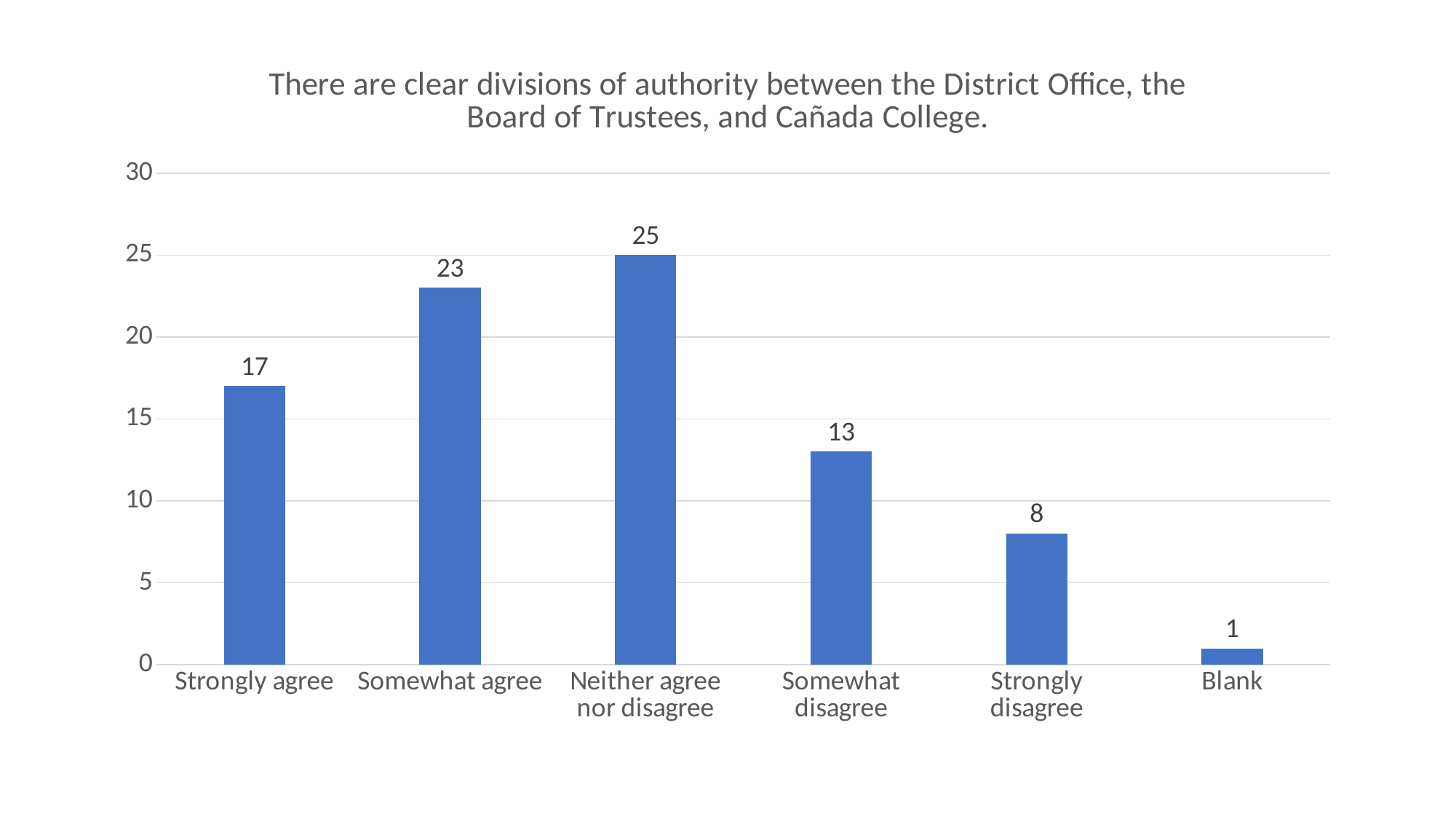
What is the value for Neither agree nor disagree? 25 Is the value for Somewhat disagree greater or less than 15? less Which category has the highest value? Neither agree nor disagree Which is larger, the value for Strongly agree or the value for Somewhat agree? Somewhat agree What kind of chart is this? bar chart What is the value for Blank? 1 What is the difference between the values for Somewhat agree and Somewhat disagree? 10 What is the title of the chart? There are clear divisions of authority between the District Office, the Board of Trustees, and Cañada College. What is the value for Strongly agree? 17 Which category has the lowest value? Blank What is the value for Strongly disagree? 8 How many categories are shown on the x axis? 6